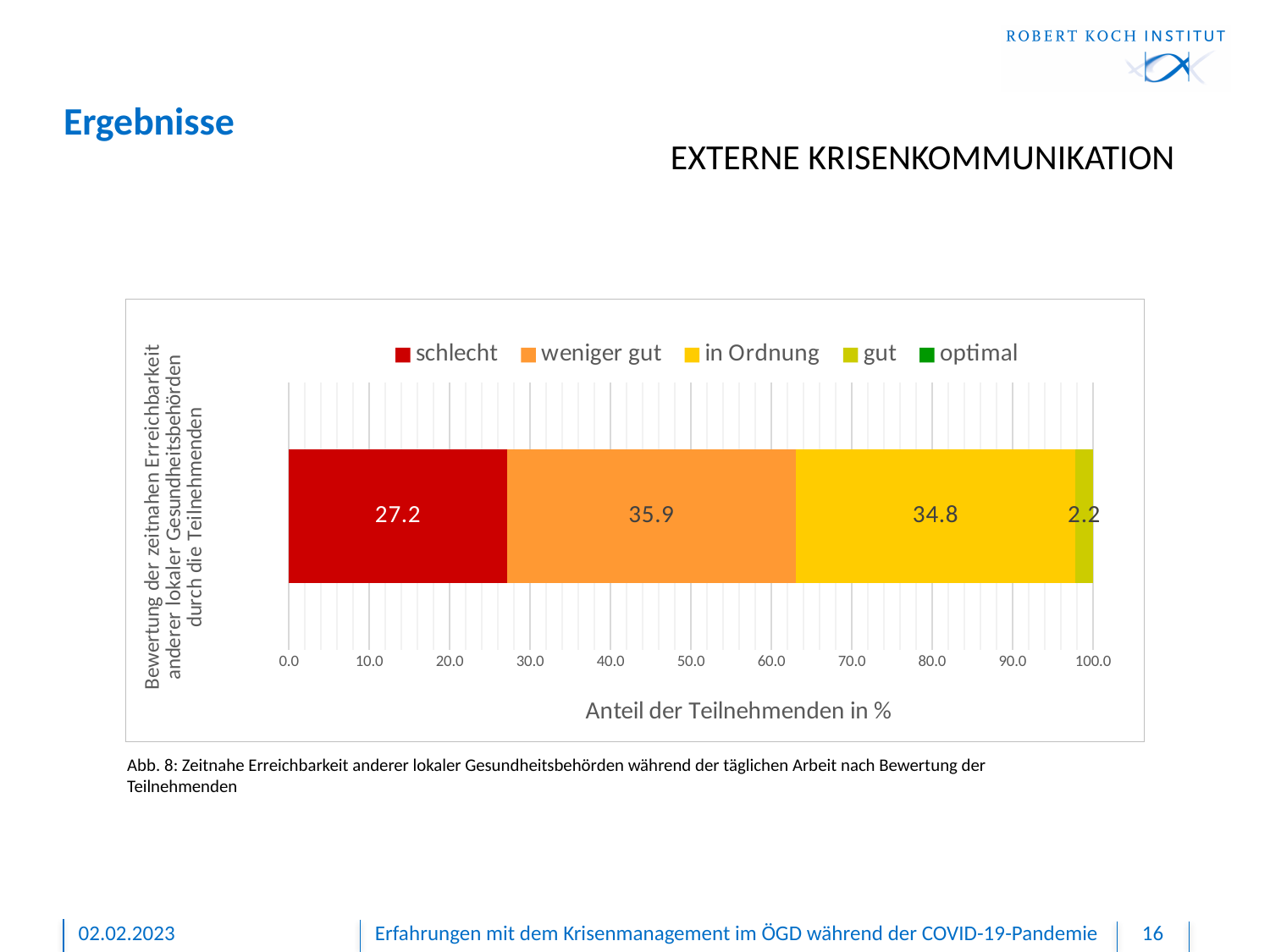
What is the difference between the 'in Ordnung' and 'gut' values? 32.6 What colour represents 'schlecht' in the legend? red What is the value for the 'weniger gut' segment? 35.9 What is the value for the 'gut' segment? 2.2 What is the title of the x axis? Anteil der Teilnehmenden in % Which segment of the bar has the largest value? weniger gut What is the value for the 'in Ordnung' segment? 34.8 What kind of chart is shown on the slide? stacked bar chart How many series does the legend list? 5 What is the value for the 'schlecht' segment? 27.2 Which is larger, the 'schlecht' value or the 'in Ordnung' value? in Ordnung What is the difference between the 'weniger gut' and 'schlecht' values? 8.7